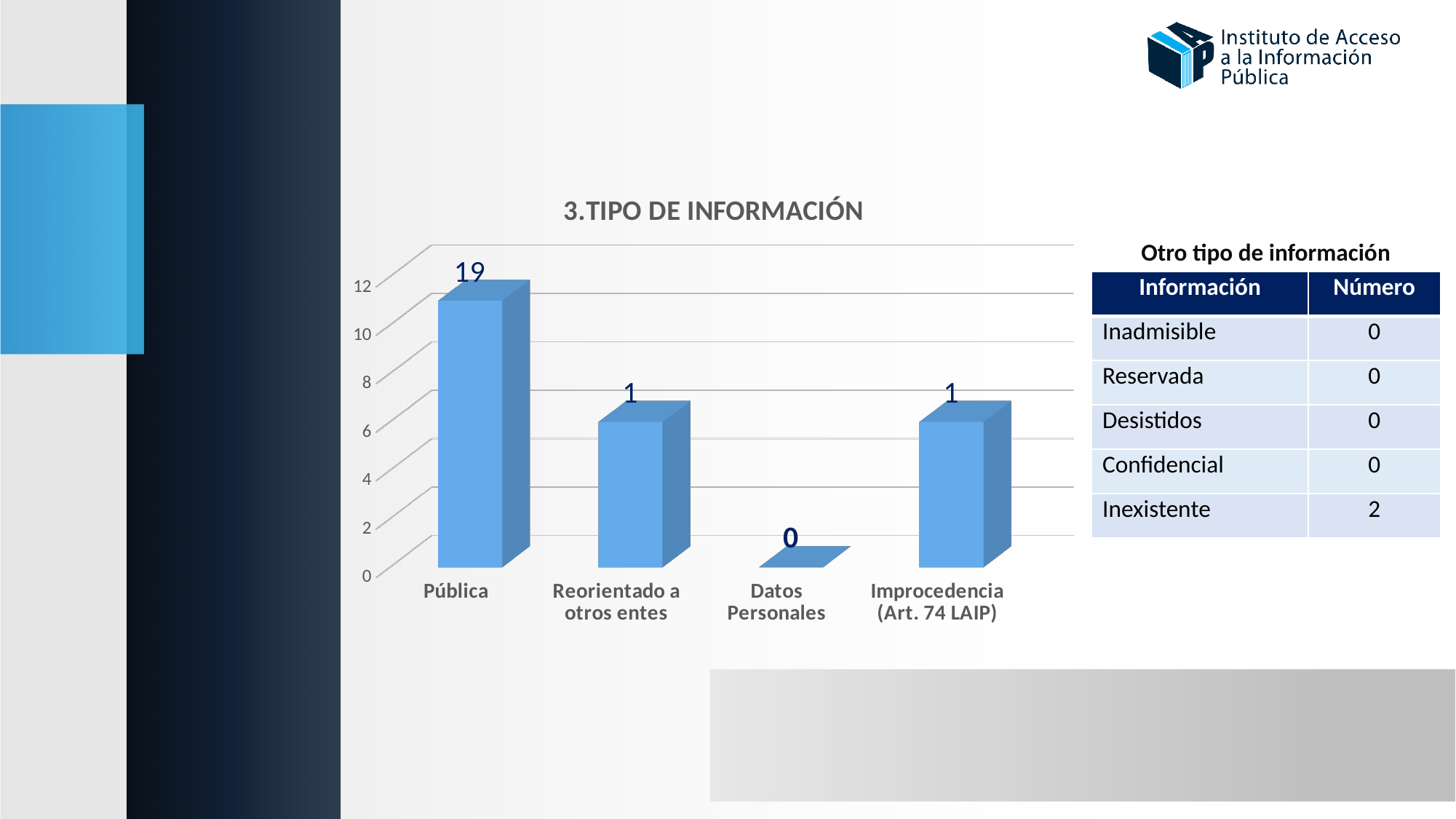
What is the value for Improcedencia (Art. 74 LAIP)? 1 What is the title of the chart? 3.TIPO DE INFORMACIÓN What is the value for Datos Personales? 0 What is the value for Pública? 19 What is the value for Reorientado a otros entes? 1 Which category has the lowest value? Datos Personales What kind of chart is shown on the slide? Bar chart What is the difference between the values for Pública and Reorientado a otros entes? 18 Which is larger, the value for Pública or the value for Improcedencia (Art. 74 LAIP)? Pública Which category has the highest value? Pública How many categories are shown on the x axis of the chart? 4 What is the highest value shown on the vertical axis of the chart? 12